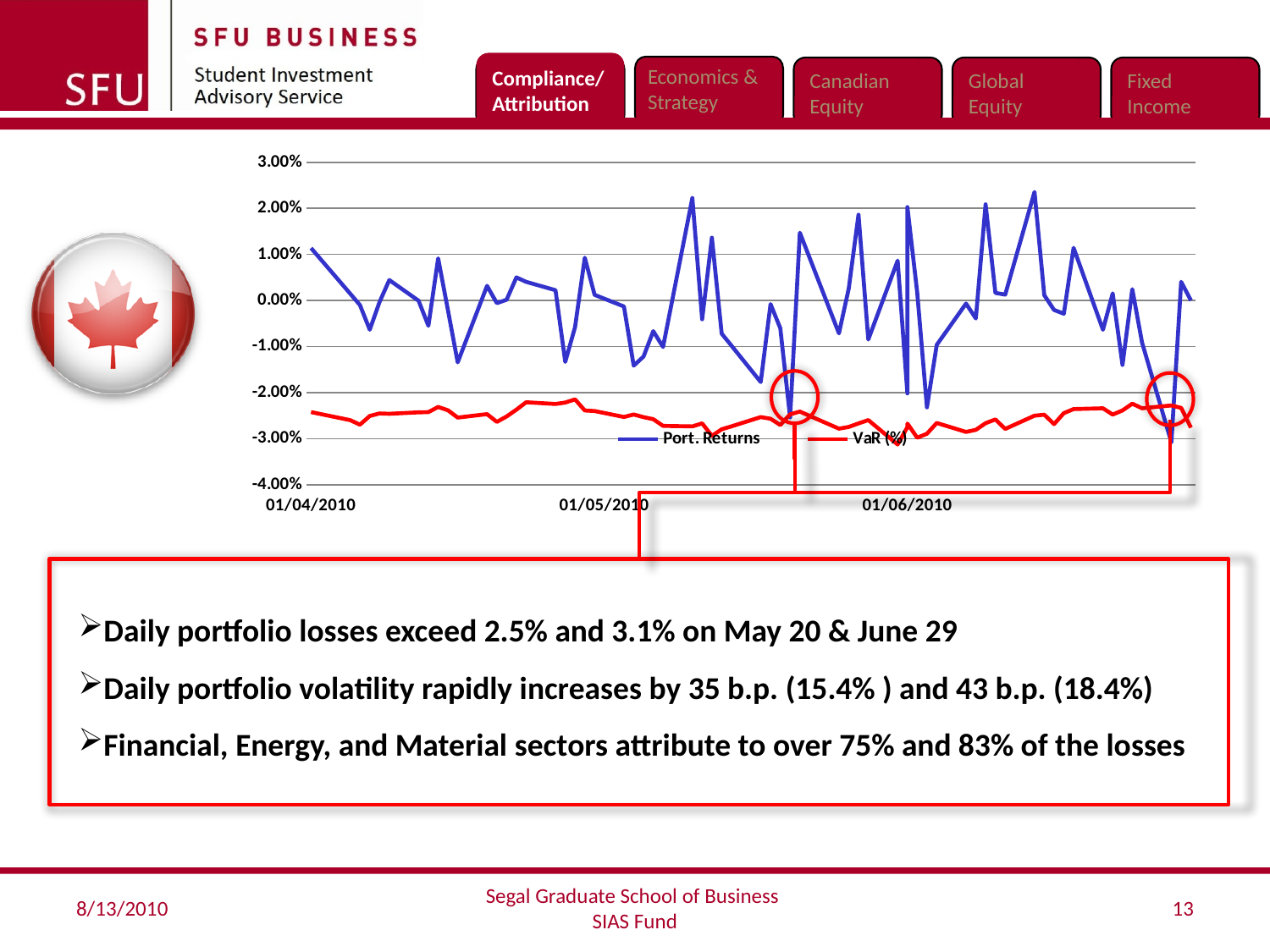
What is the first date label on the x axis of the chart? 01/04/2010 What is the highest value shown on the y axis of the chart? 3.00% What colour is the Port. Returns line in the chart? blue Is the lowest point of the Port. Returns line greater or less than -2.00%? less Is the highest point of the Port. Returns line greater or less than 2.00%? greater Which series shows more fluctuation across the chart, Port. Returns or VaR (%)? Port. Returns How many series does the chart's legend list? 2 What is the lowest value shown on the y axis of the chart? -4.00% How many date labels are shown on the x axis of the chart? 3 What kind of chart is shown on the slide? line chart What are the two series named in the chart's legend? Port. Returns and VaR (%) Is the VaR (%) line at 01/04/2010 greater or less than -2.00%? less